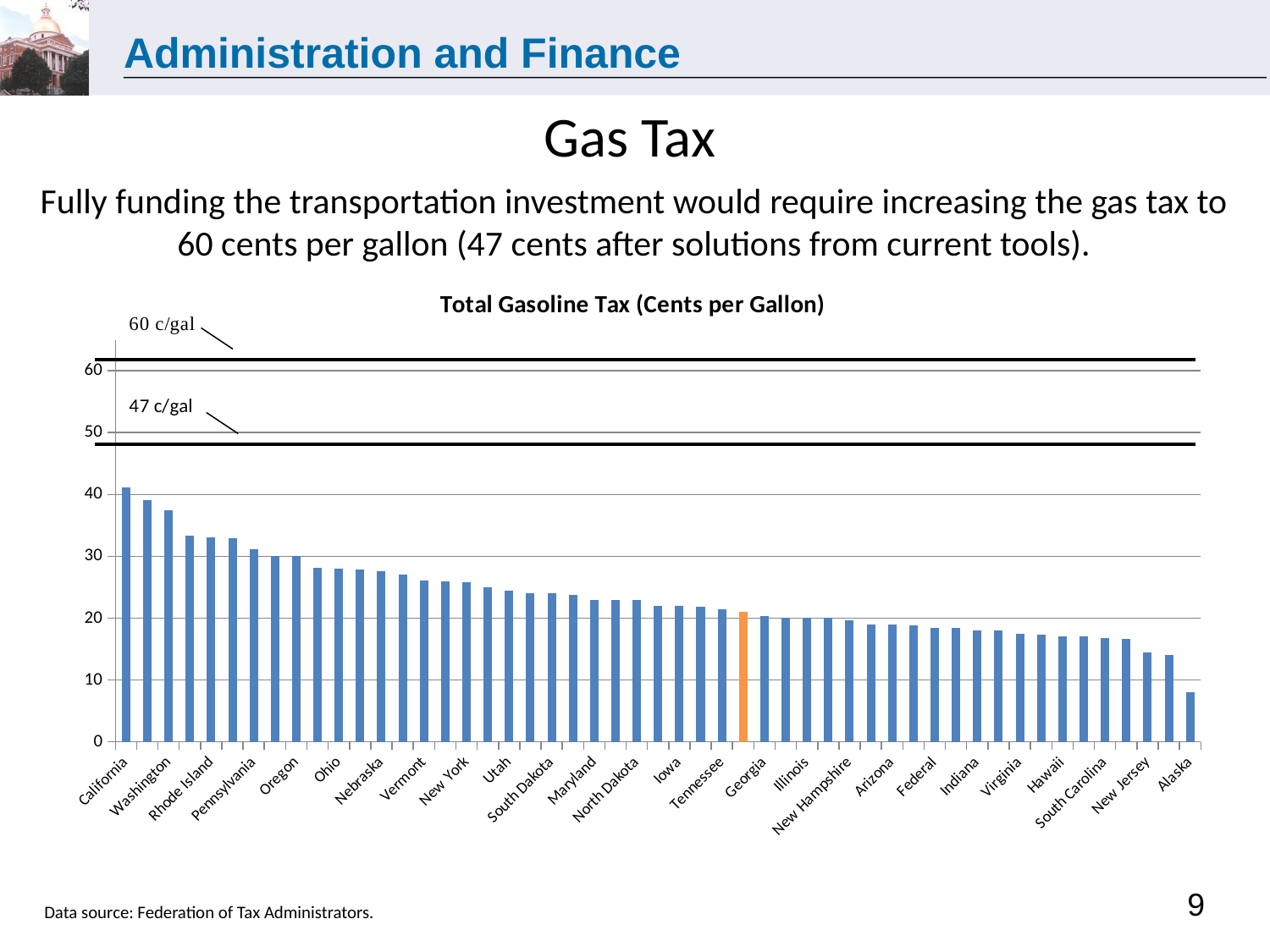
Is the value for Washington greater or less than 30? greater Which state has the lowest total gasoline tax in the chart? Alaska Which state has the highest total gasoline tax in the chart? California What two reference levels are marked by the horizontal lines drawn across the chart? 60 c/gal and 47 c/gal Is the value for Alaska greater or less than 10? less What is the title of the chart? Total Gasoline Tax (Cents per Gallon) Is the value for Utah greater or less than 20? greater What kind of chart is shown on the slide? bar chart Which has the larger total gasoline tax, Vermont or New Jersey? Vermont Do the bar values rise or fall moving from left to right along the x axis? fall